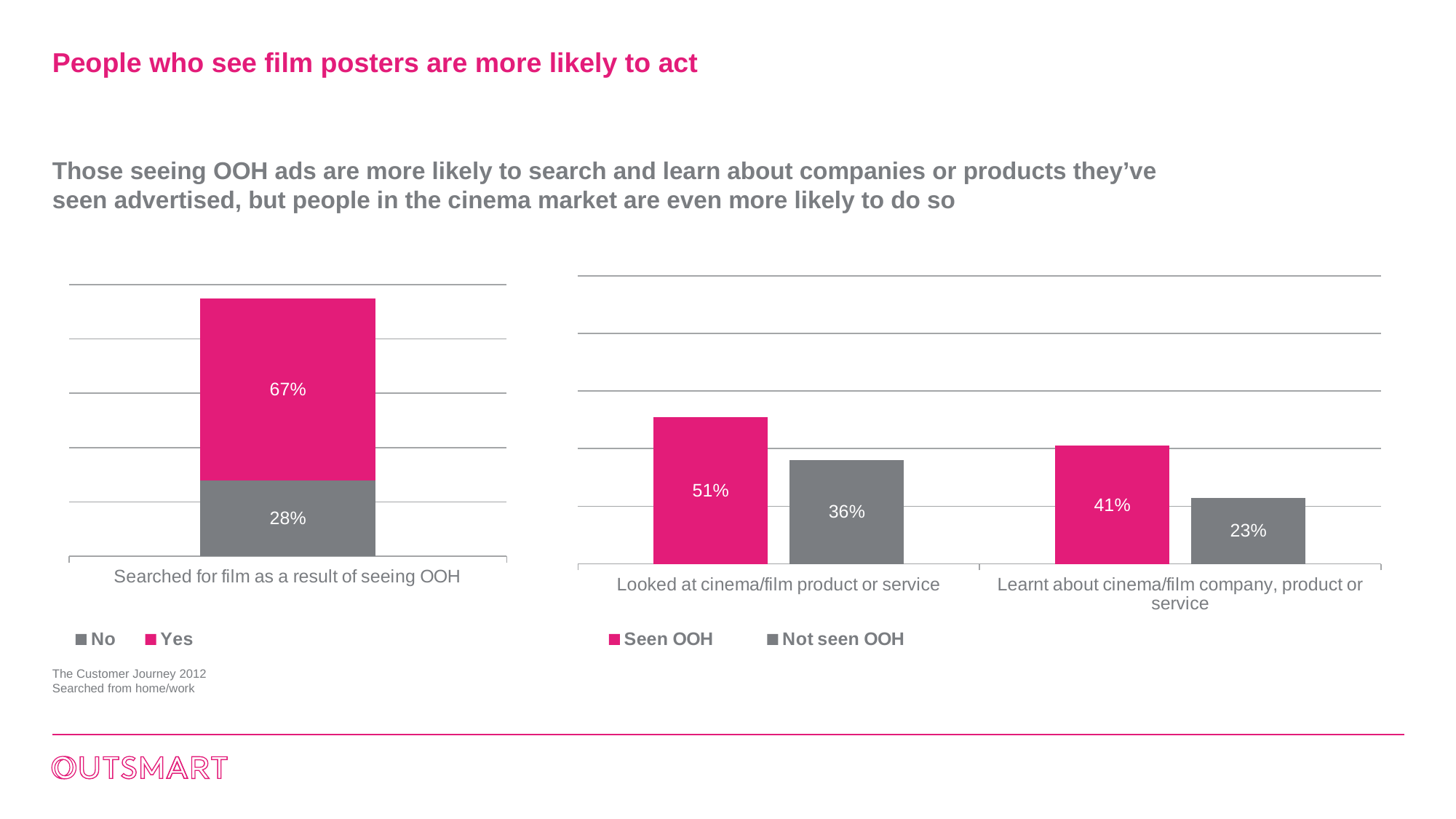
In the right chart, what is the difference between Seen OOH and Not seen OOH for 'Looked at cinema/film product or service'? 15% In the left chart, what is the total of the stacked bar for 'Searched for film as a result of seeing OOH'? 95% How many categories are shown on the x axis of the right chart? 2 In the left chart, what is the value for Yes in 'Searched for film as a result of seeing OOH'? 67% How many series does the legend of the right chart list? 2 In the right chart, what is the value for Not seen OOH in 'Learnt about cinema/film company, product or service'? 23% In the right chart, which category has the lowest Not seen OOH value? Learnt about cinema/film company, product or service In the left chart, what is the difference between the Yes and No values? 39% What kind of chart is the left chart? Stacked bar chart In the right chart, which is larger for 'Learnt about cinema/film company, product or service': Seen OOH or Not seen OOH? Seen OOH In the left chart, what is the value for No in 'Searched for film as a result of seeing OOH'? 28% In the right chart, what is the value for Seen OOH in 'Looked at cinema/film product or service'? 51%